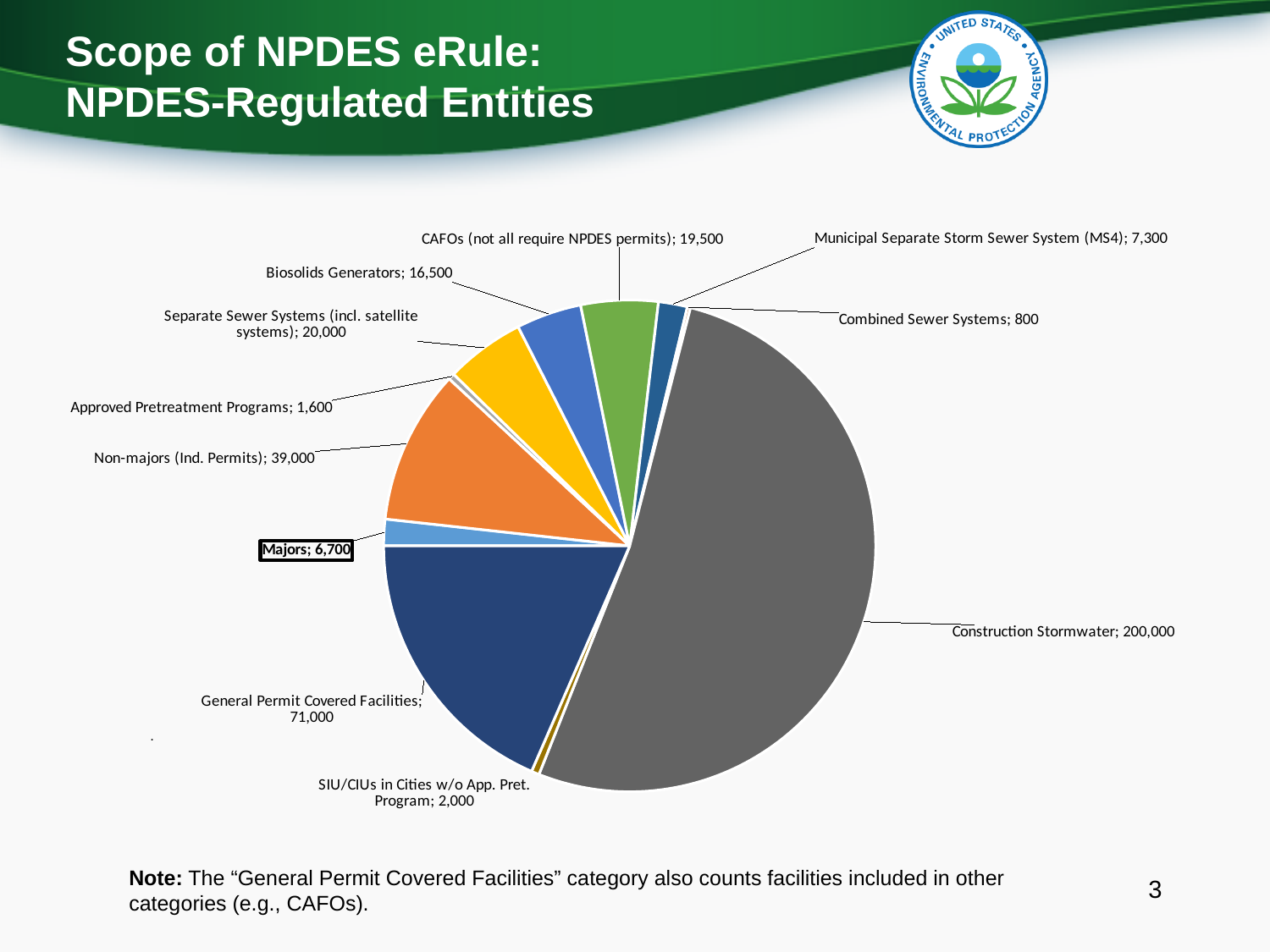
Which category's label is shown in a boxed, bold callout? Majors; 6,700 What is the value for General Permit Covered Facilities? 71,000 What is the value for Biosolids Generators? 16,500 Which is larger, Separate Sewer Systems (incl. satellite systems) or CAFOs (not all require NPDES permits)? Separate Sewer Systems (incl. satellite systems) What type of chart is shown on the slide? Pie chart How many categories are shown in the pie chart? 11 What is the value for Majors? 6,700 What is the value for Construction Stormwater? 200,000 What is the difference between Non-majors (Ind. Permits) and Majors? 32,300 What is the difference between Construction Stormwater and General Permit Covered Facilities? 129,000 Which category has the smallest value? Combined Sewer Systems Which category has the largest value? Construction Stormwater